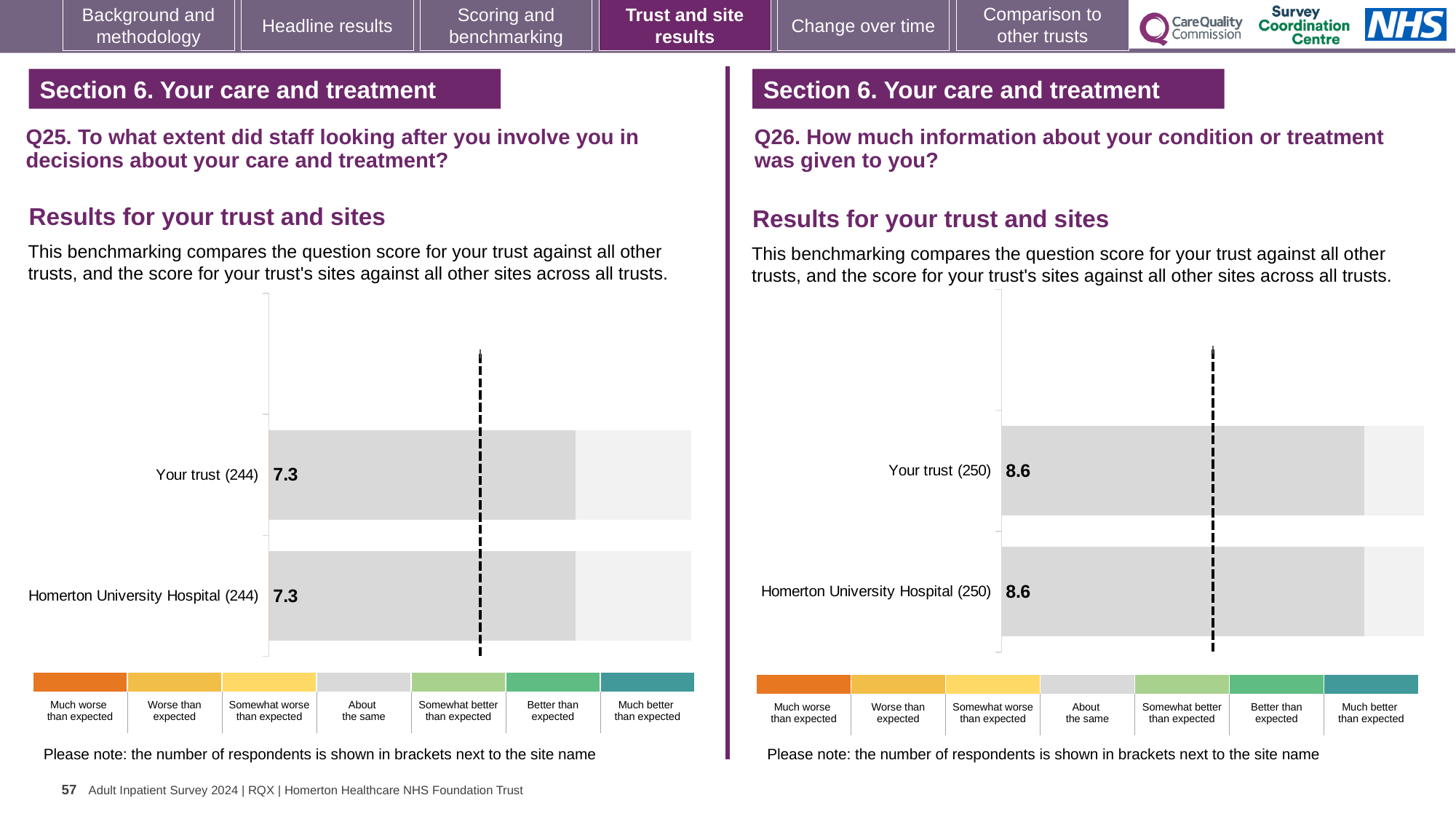
On the Q25 chart (left), how many respondents are shown in brackets next to Your trust? 244 On the Q26 chart (right), what is the score for Homerton University Hospital? 8.6 How many bars are plotted on the Q26 chart (right)? 2 On the Q25 chart (left), what is the score for Your trust? 7.3 What kind of chart is the Q25 chart (left)? Bar chart Is the score for Your trust on the Q26 chart (right) larger or smaller than the score for Your trust on the Q25 chart (left)? Larger On the Q26 chart (right), what is the score for Your trust? 8.6 How many bars are plotted on the Q25 chart (left)? 2 On the Q25 chart (left), what is the score for Homerton University Hospital? 7.3 On the Q26 chart (right), what is the difference between the score for Your trust and the score for Homerton University Hospital? 0 On the Q25 chart (left), what is the difference between the score for Your trust and the score for Homerton University Hospital? 0 On the Q26 chart (right), how many respondents are shown in brackets next to Homerton University Hospital? 250